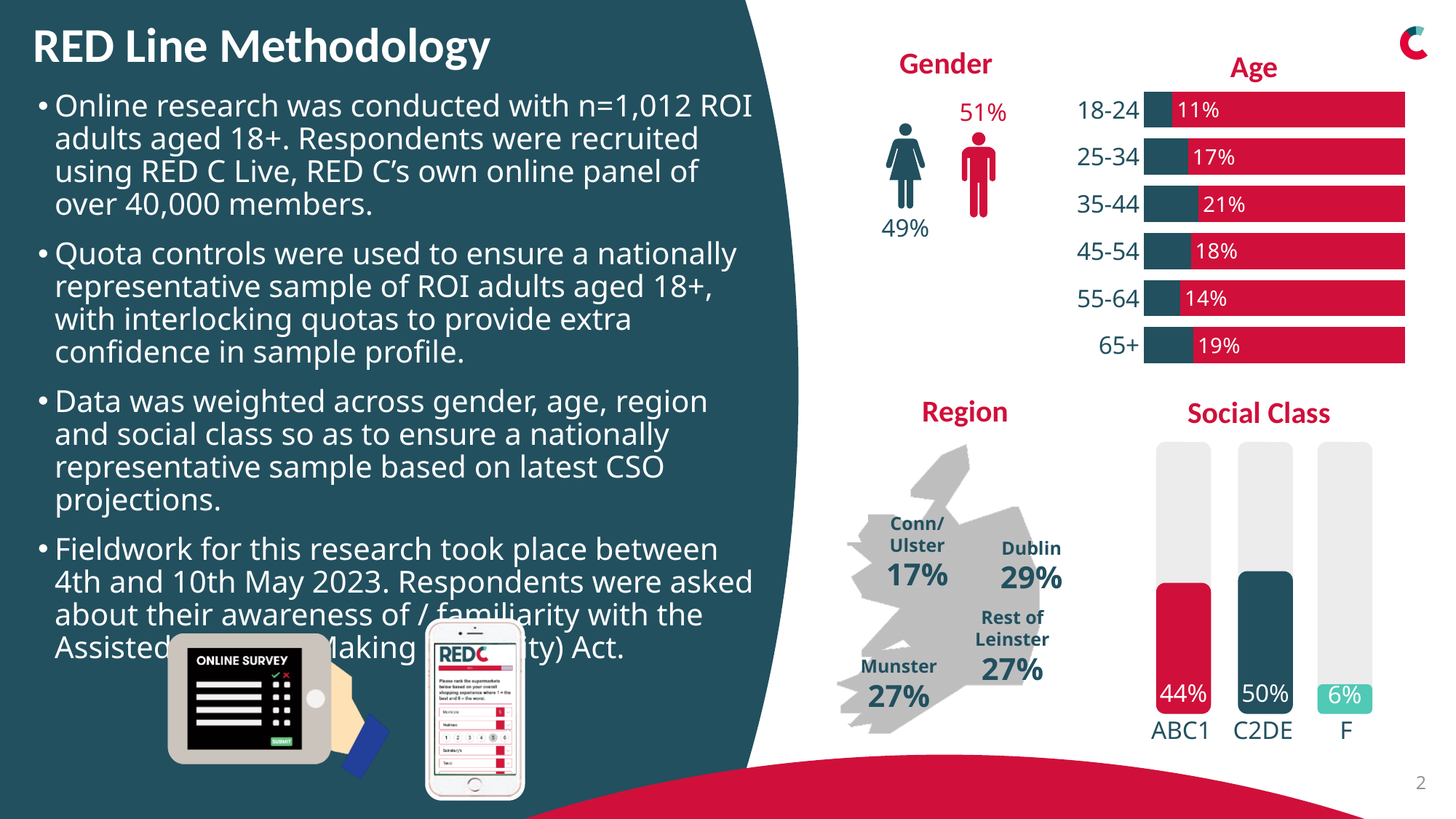
In the Age chart, which age group has the lowest percentage? 18-24 In the Social Class chart, which social class has the lowest value? F What kind of chart is the Age chart? bar chart In the Social Class chart, what is the value for C2DE? 50% In the Region chart, what percentage of respondents are from Dublin? 29% In the Social Class chart, which is larger, ABC1 or C2DE? C2DE In the Age chart, which age group has the highest percentage? 35-44 In the Gender chart, what percentage of respondents are female? 49% In the Age chart, what is the difference between the 65+ group and the 55-64 group? 5% In the Social Class chart, what is the difference between ABC1 and F? 38% In the Age chart, how many age groups are shown? 6 In the Age chart, what percentage of respondents are aged 35-44? 21%